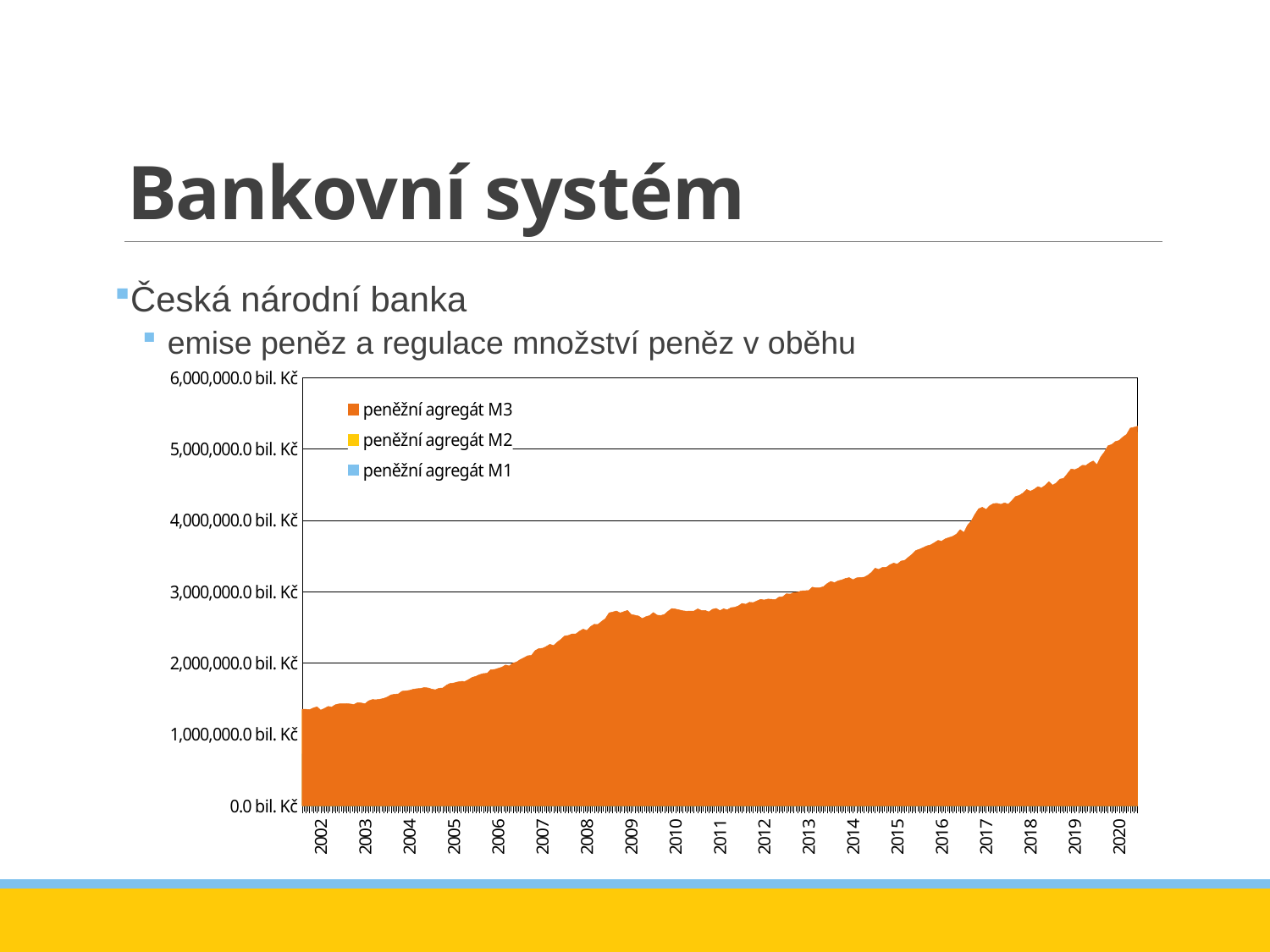
Is the value for peněžní agregát M3 in 2018 greater or less than 4,000,000.0 bil. Kč? greater What is the highest value shown on the chart's y axis? 6,000,000.0 bil. Kč Is the value for peněžní agregát M3 in 2020 greater or less than 5,000,000.0 bil. Kč? greater Is the value for peněžní agregát M3 in 2010 greater or less than 3,000,000.0 bil. Kč? less What kind of chart is shown on the slide? area chart Which series is shown in orange in the chart legend? peněžní agregát M3 Do the values in the chart generally rise or fall from 2002 to 2020? rise How many series does the chart legend list? 3 How many year labels are shown on the x axis of the chart? 19